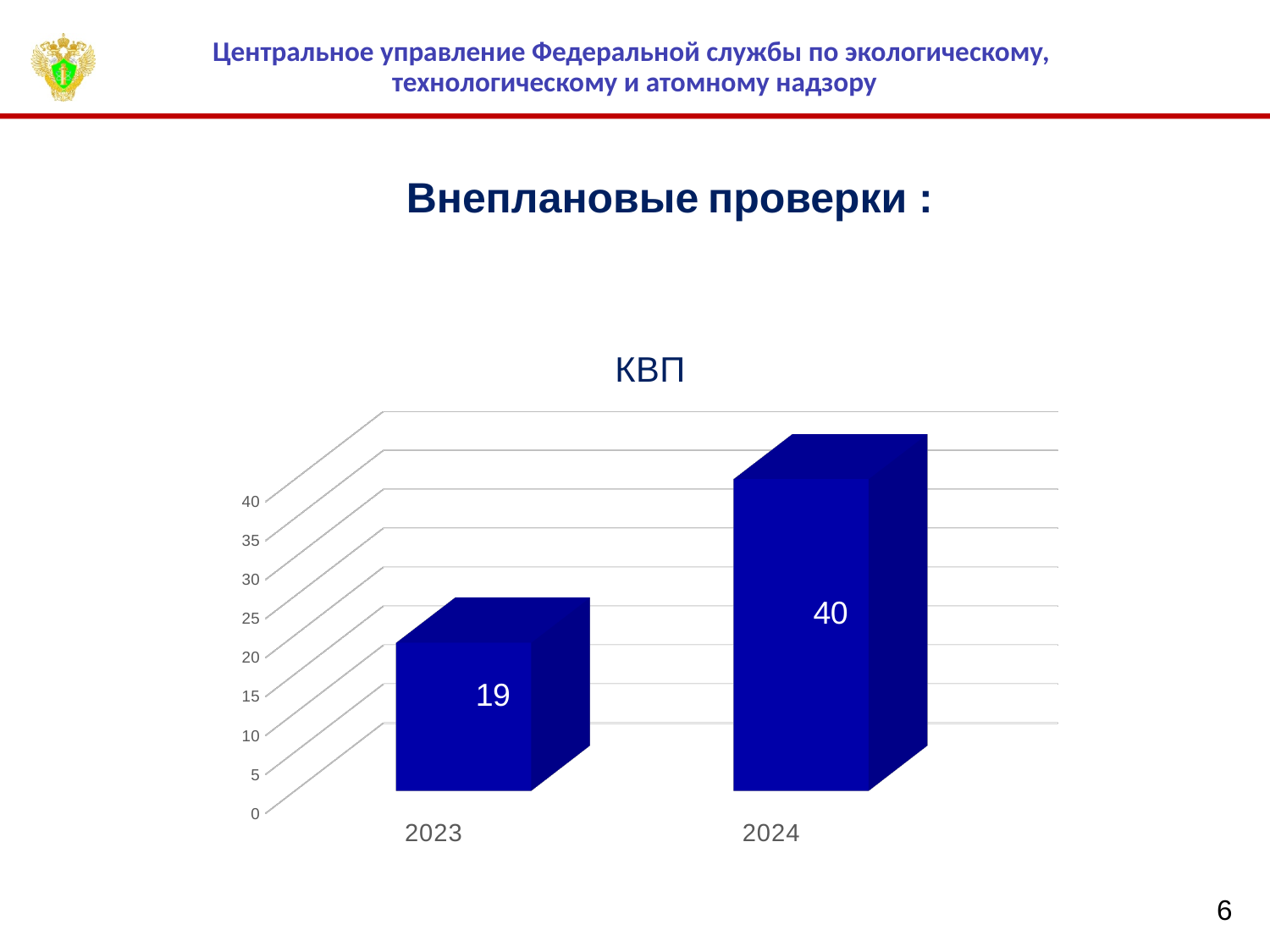
Do the values in the КВП chart rise or fall from 2023 to 2024? rise What is the difference between the values for 2024 and 2023 in the КВП chart? 21 What kind of chart is shown on the slide? bar chart Which year has the lowest value in the КВП chart? 2023 How many categories are shown in the КВП chart? 2 What is the value for 2023 in the КВП chart? 19 Is the value for 2024 in the КВП chart greater or less than 35? greater Which is larger in the КВП chart, the value for 2023 or the value for 2024? 2024 Which year has the highest value in the КВП chart? 2024 Is the value for 2023 in the КВП chart greater or less than 20? less What is the value for 2024 in the КВП chart? 40 What is the title of the chart on the slide? КВП